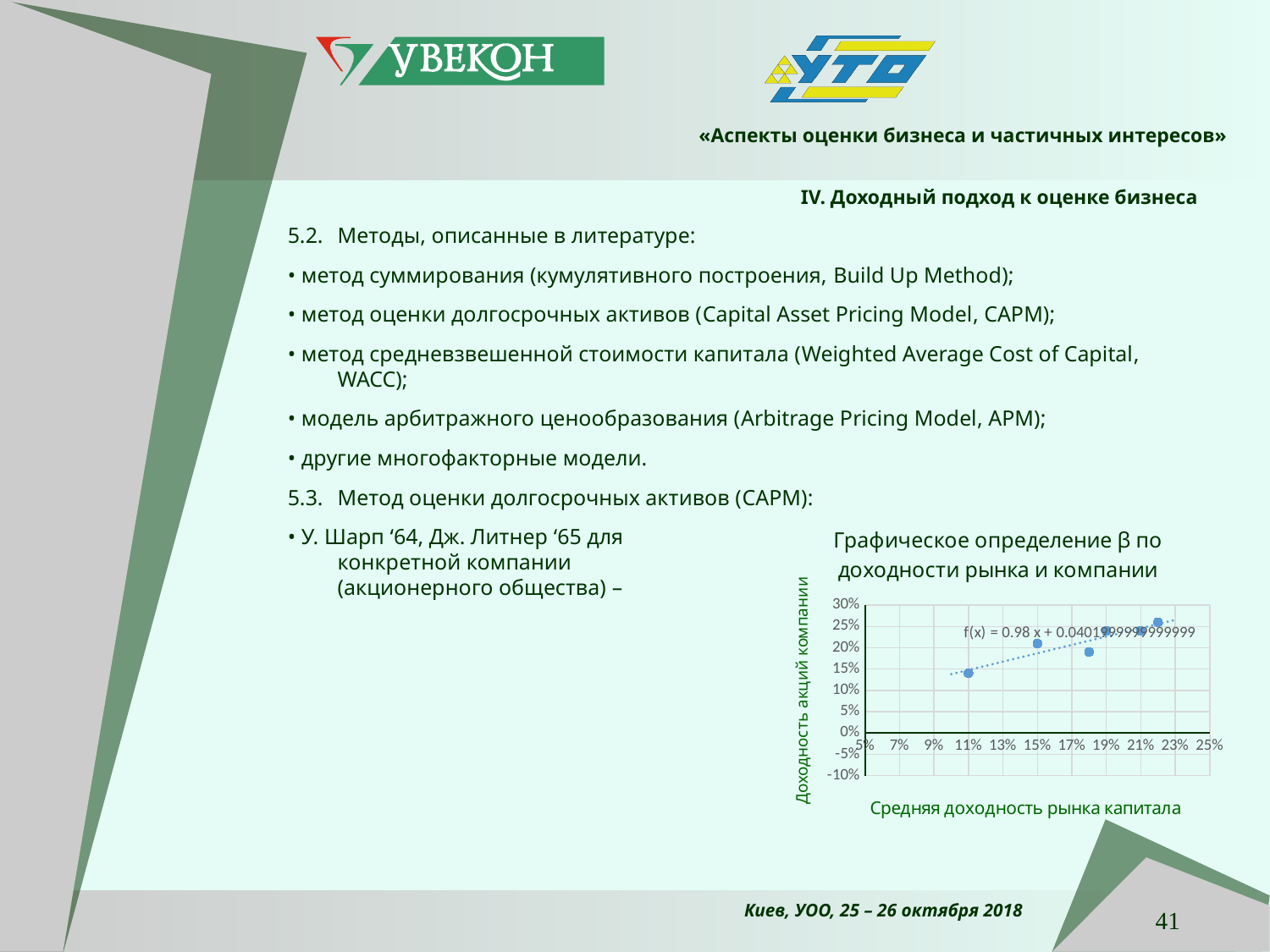
Is the company return for the point at about 15% market return greater or less than 15%? greater What kind of chart is shown on the slide? scatter chart What is the lowest tick value shown on the vertical axis? -10% What is the slope coefficient of x in the trendline equation shown on the chart? 0.98 Do the plotted points rise or fall as the market return increases along the x axis? rise What is the title of the chart on the slide? Графическое определение β по доходности рынка и компании Is the company return for the point at about 11% market return greater or less than 10%? greater What is the highest tick value shown on the horizontal axis? 25% What is the highest tick value shown on the vertical axis? 30% Which has the higher company return: the point at about 11% market return or the point at about 21% market return? the point at about 21% market return What is the label of the horizontal axis of the chart? Средняя доходность рынка капитала